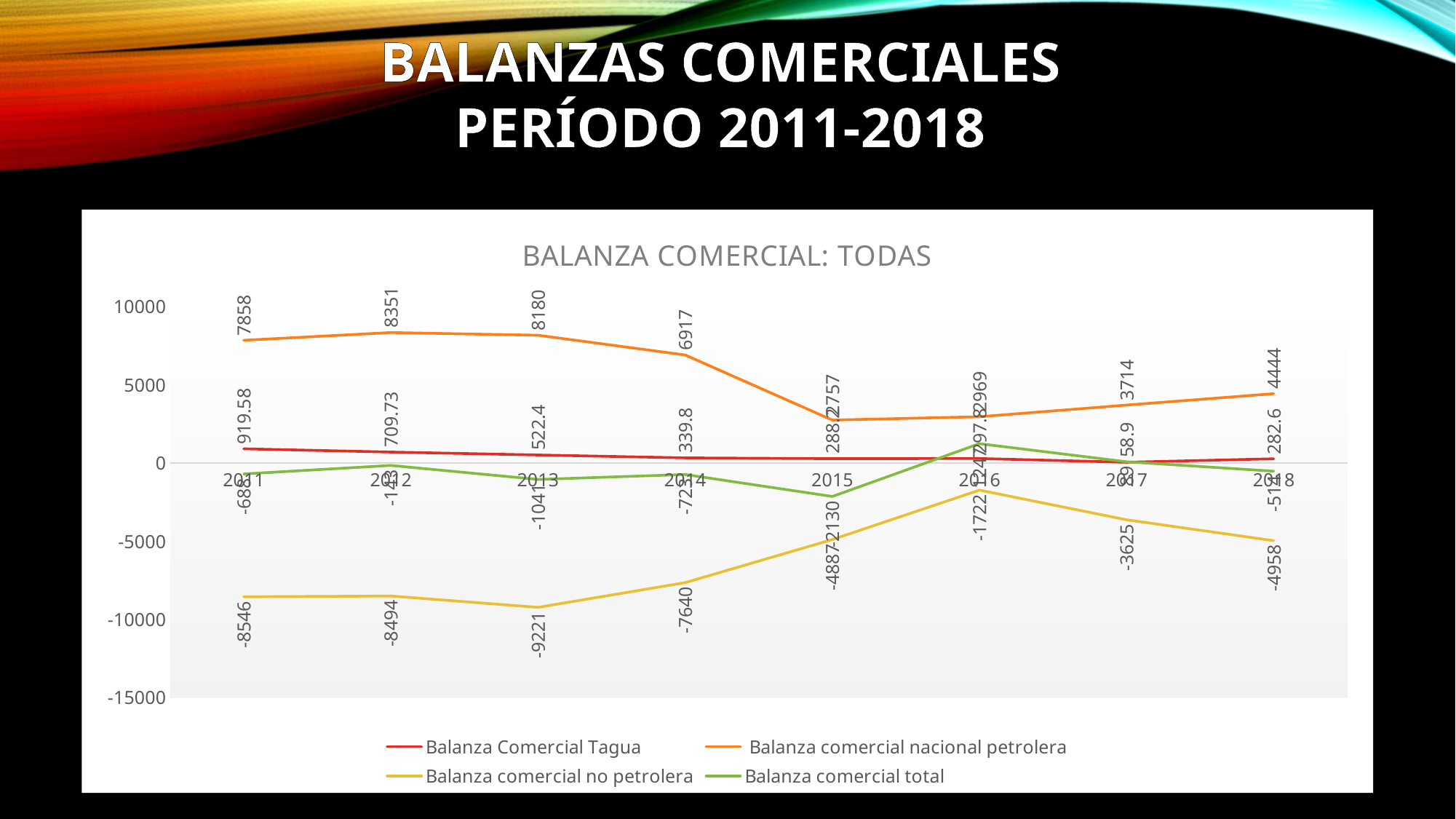
What is the value of Balanza comercial no petrolera in 2013? -9221 What is the value of Balanza Comercial Tagua in 2011? 919.58 How many years are plotted along the x axis? 8 In which year is Balanza comercial no petrolera lowest? 2013 Is the value of Balanza comercial total in 2015 greater or less than 0? less Which year has the larger Balanza comercial nacional petrolera value, 2017 or 2018? 2018 What is the difference between the Balanza comercial nacional petrolera values for 2012 and 2011? 493 In which year is Balanza comercial nacional petrolera highest? 2012 Does Balanza Comercial Tagua rise or fall from 2011 to 2014? fall What is the value of Balanza comercial nacional petrolera in 2012? 8351 What kind of chart is shown on the slide? line chart How many series does the legend list? 4